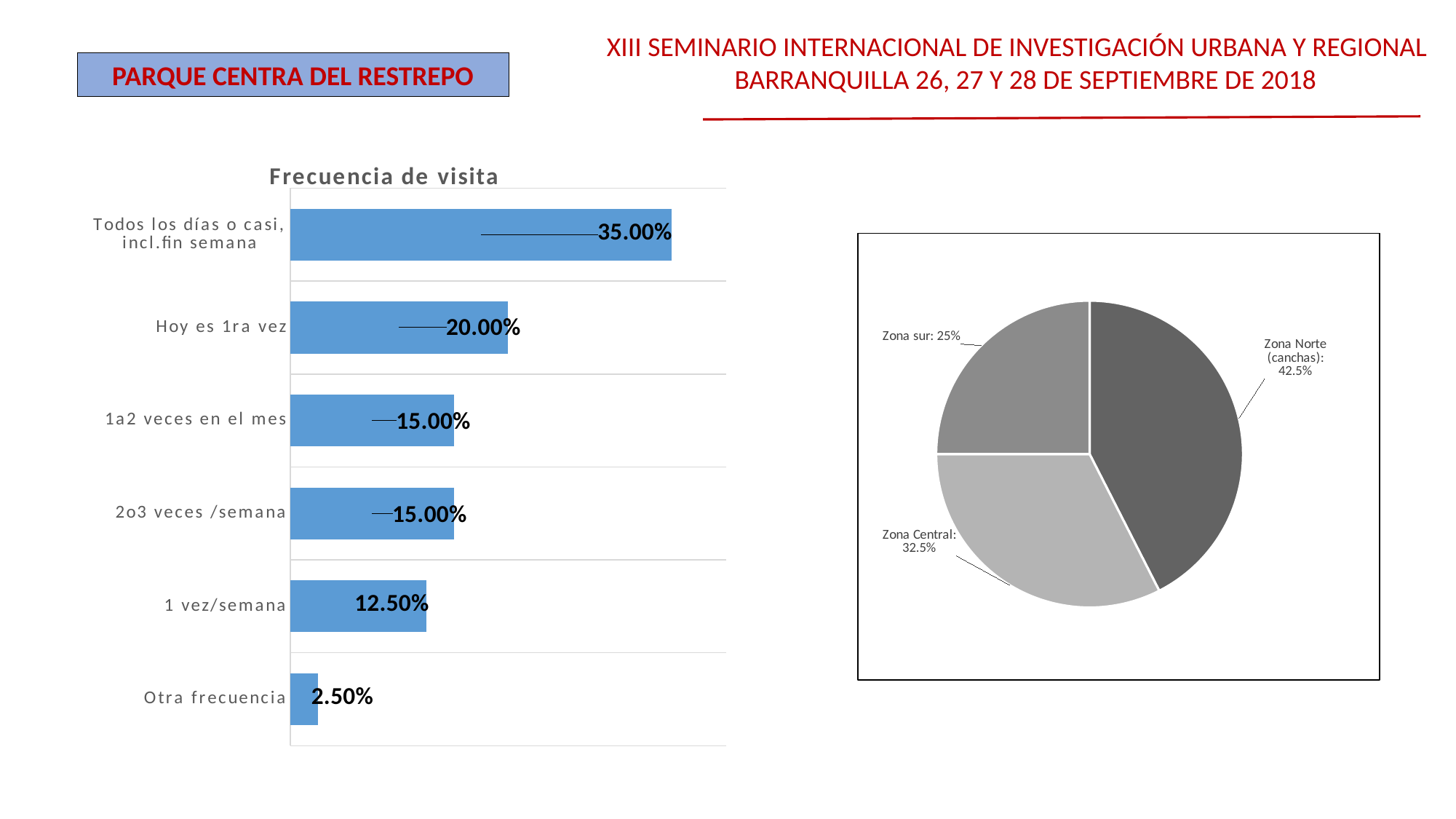
In the 'Frecuencia de visita' chart, what is the difference between 'Todos los días o casi, incl.fin semana' and '1 vez/semana'? 22.50% How many categories does the 'Frecuencia de visita' chart show? 6 In the pie chart on the right, what is the difference between 'Zona Norte (canchas)' and 'Zona sur'? 17.5% In the 'Frecuencia de visita' chart, what is the value for 'Otra frecuencia'? 2.50% How many slices does the pie chart on the right have? 3 In the 'Frecuencia de visita' chart, what is the value for 'Hoy es 1ra vez'? 20.00% In the 'Frecuencia de visita' chart, which category has the highest value? Todos los días o casi, incl.fin semana In the pie chart on the right, what share does 'Zona Central' have? 32.5% In the 'Frecuencia de visita' chart, which category has the lowest value? Otra frecuencia In the 'Frecuencia de visita' chart, which is larger: 'Hoy es 1ra vez' or '1 vez/semana'? Hoy es 1ra vez In the pie chart on the right, which zone has the largest slice? Zona Norte (canchas) What kind of chart is the 'Frecuencia de visita' chart? Bar chart